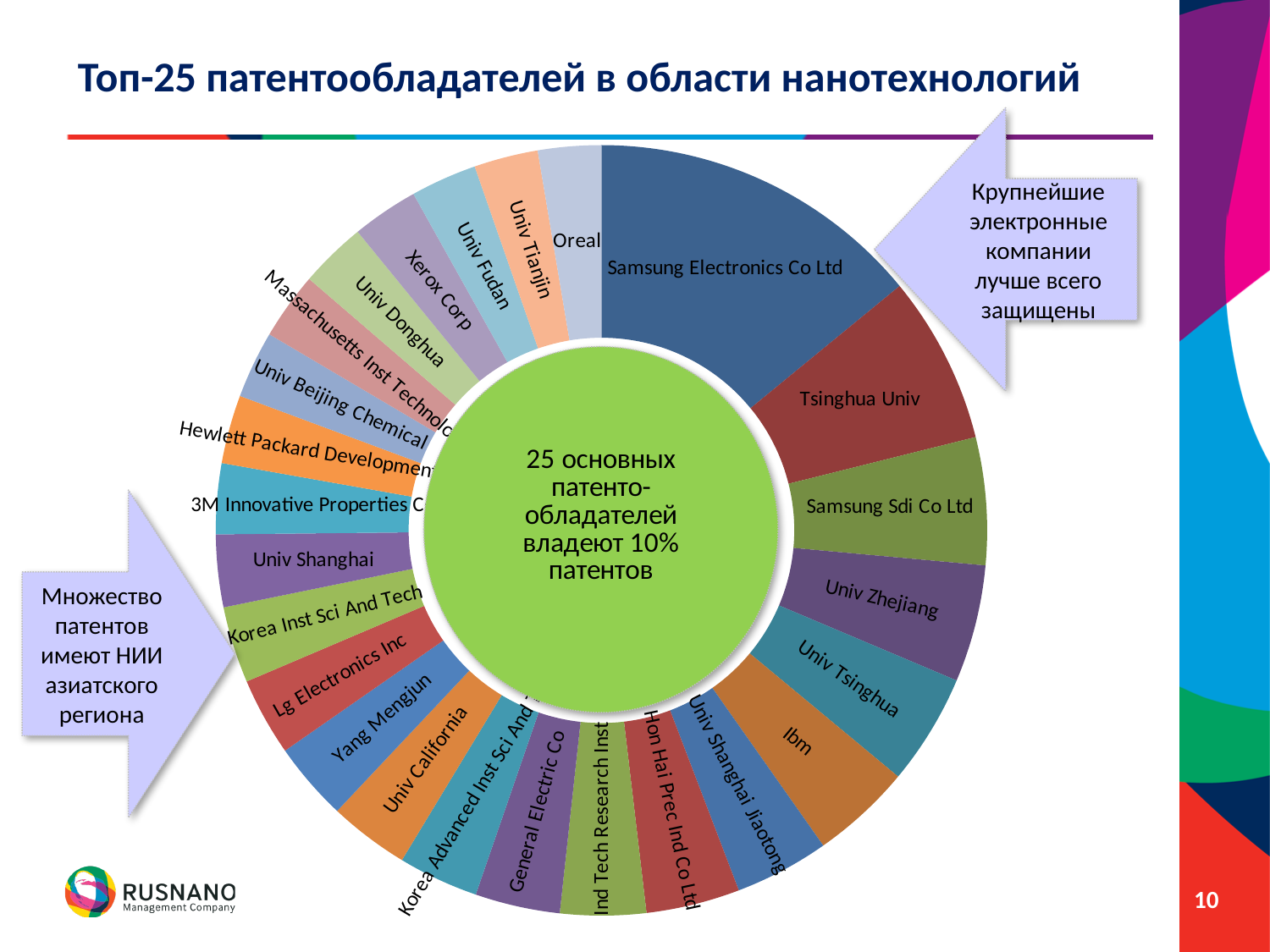
Which segment is larger, Samsung Electronics Co Ltd or Tsinghua Univ? Samsung Electronics Co Ltd Which segment is larger, Samsung Sdi Co Ltd or Univ Fudan? Samsung Sdi Co Ltd What is the title of the slide containing the chart? Топ-25 патентообладателей в области нанотехнологий How many patent holders are shown in the chart? 25 What kind of chart is shown on the slide? doughnut chart According to the text in the centre of the chart, what share of patents do the 25 main patent holders own? 10% Which segment is larger, Samsung Electronics Co Ltd or Oreal? Samsung Electronics Co Ltd Which patent holder has the largest segment in the chart? Samsung Electronics Co Ltd